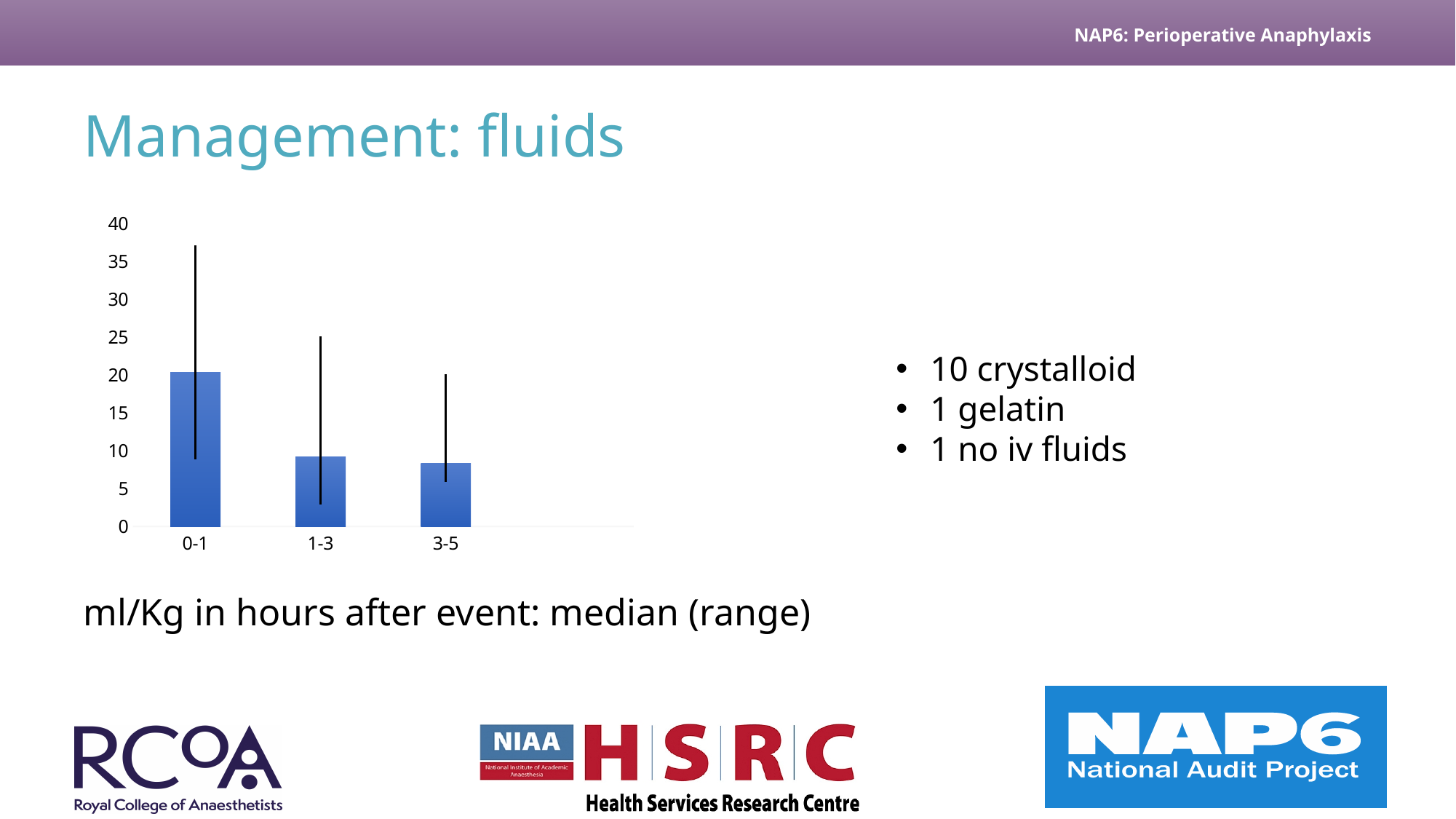
Is the value for 3-5 greater or less than 10? less Which category has the highest bar in the chart? 0-1 Is the value for 1-3 greater or less than 15? less What kind of chart is shown on the slide? bar chart What is the highest value shown on the y axis of the chart? 40 What does the caption below the chart say the values represent? ml/Kg in hours after event: median (range) Is the value for 0-1 greater or less than 25? less Which is larger, the value for 0-1 or the value for 1-3? 0-1 Do the bar values rise or fall from left to right along the x axis? fall How many categories are shown on the x axis of the chart? 3